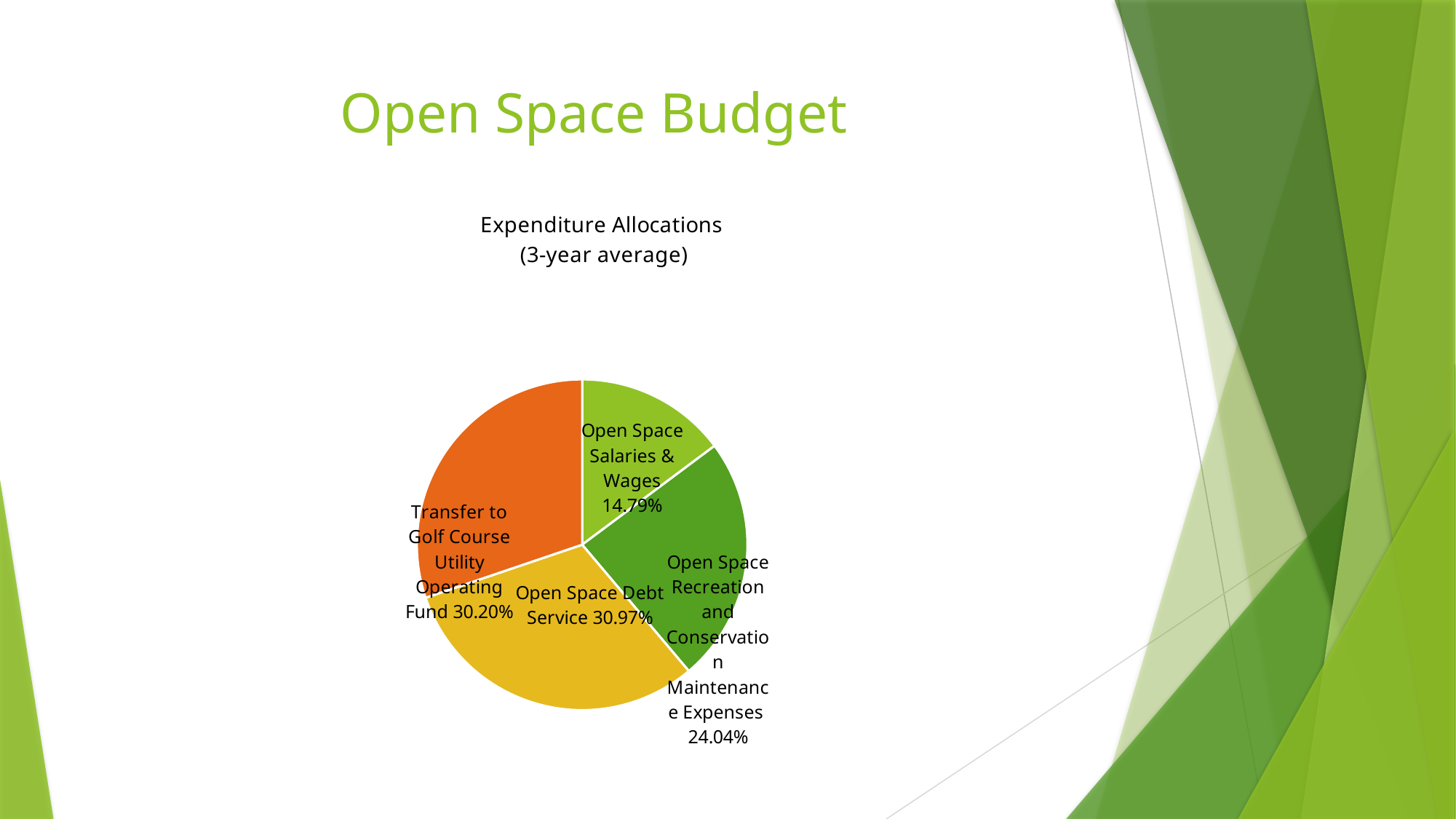
What share of expenditure allocations goes to Open Space Recreation and Conservation Maintenance Expenses? 24.04% Which is larger: the share for Open Space Recreation and Conservation Maintenance Expenses or the share for Open Space Salaries & Wages? Open Space Recreation and Conservation Maintenance Expenses What share of expenditure allocations goes to Open Space Salaries & Wages? 14.79% What kind of chart is shown on the slide? Pie chart What share of expenditure allocations goes to Open Space Debt Service? 30.97% Which category has the largest share of expenditure allocations? Open Space Debt Service Which category has the smallest share of expenditure allocations? Open Space Salaries & Wages How many slices does the pie chart have? 4 What colour is the Transfer to Golf Course Utility Operating Fund slice? Orange What is the title of the chart? Expenditure Allocations (3-year average) How many percentage points larger is the Open Space Debt Service share than the Open Space Salaries & Wages share? 16.18 What share of expenditure allocations goes to the Transfer to Golf Course Utility Operating Fund? 30.20%